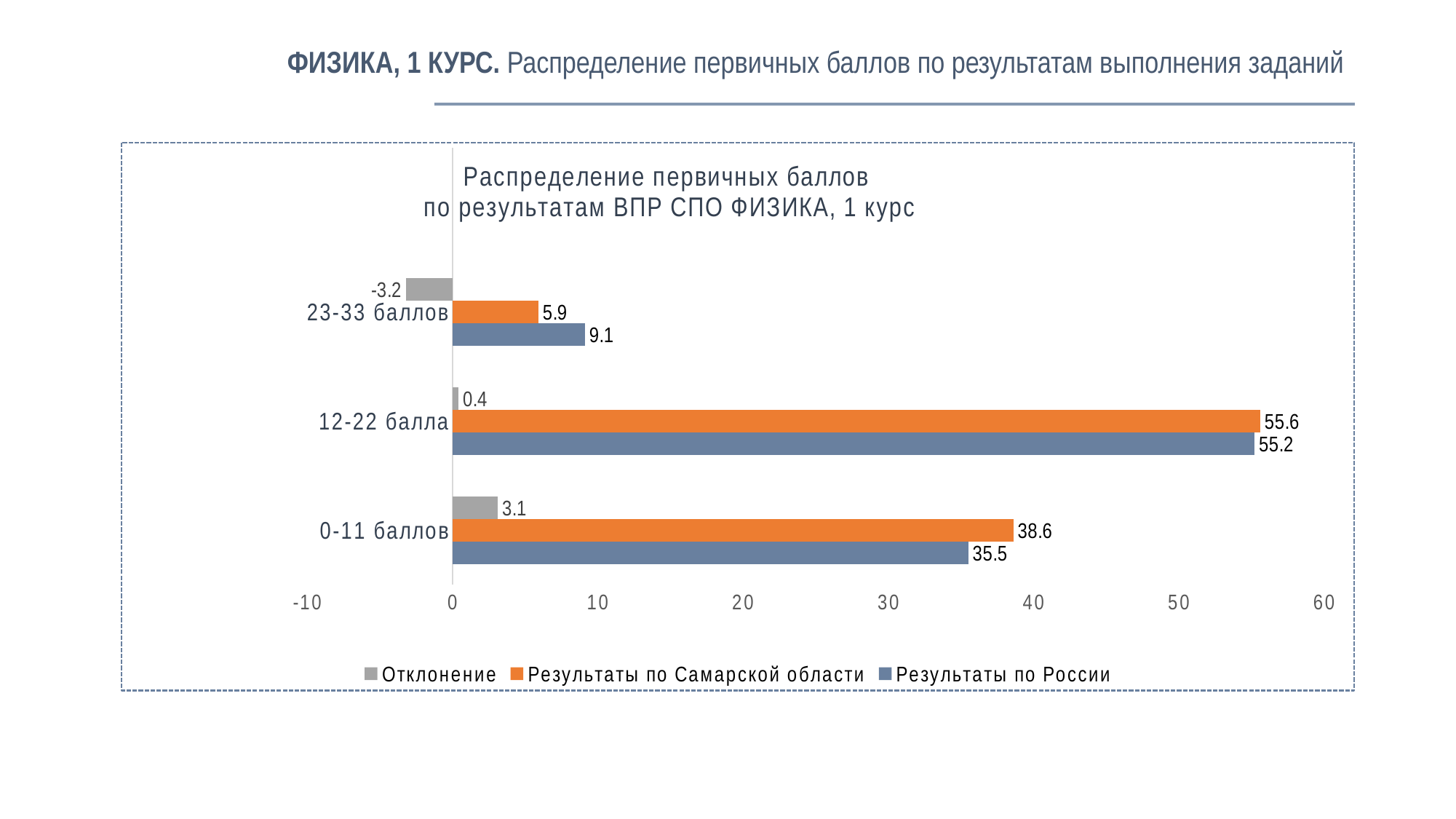
What is the difference between Результаты по Самарской области and Результаты по России in the 0-11 баллов category? 3.1 What is the Отклонение value for the 23-33 баллов category? -3.2 Which series is shown in orange? Результаты по Самарской области What kind of chart is shown on the slide? Bar chart How many score categories are shown on the chart? 3 What is the value for Результаты по Самарской области in the 12-22 балла category? 55.6 What is the value for Результаты по России in the 23-33 баллов category? 9.1 What is the value for Результаты по России in the 0-11 баллов category? 35.5 Which category has the highest value for Результаты по Самарской области? 12-22 балла How many series does the legend list? 3 In the 23-33 баллов category, which is larger: Результаты по Самарской области or Результаты по России? Результаты по России Which category has the lowest value for Результаты по России? 23-33 баллов